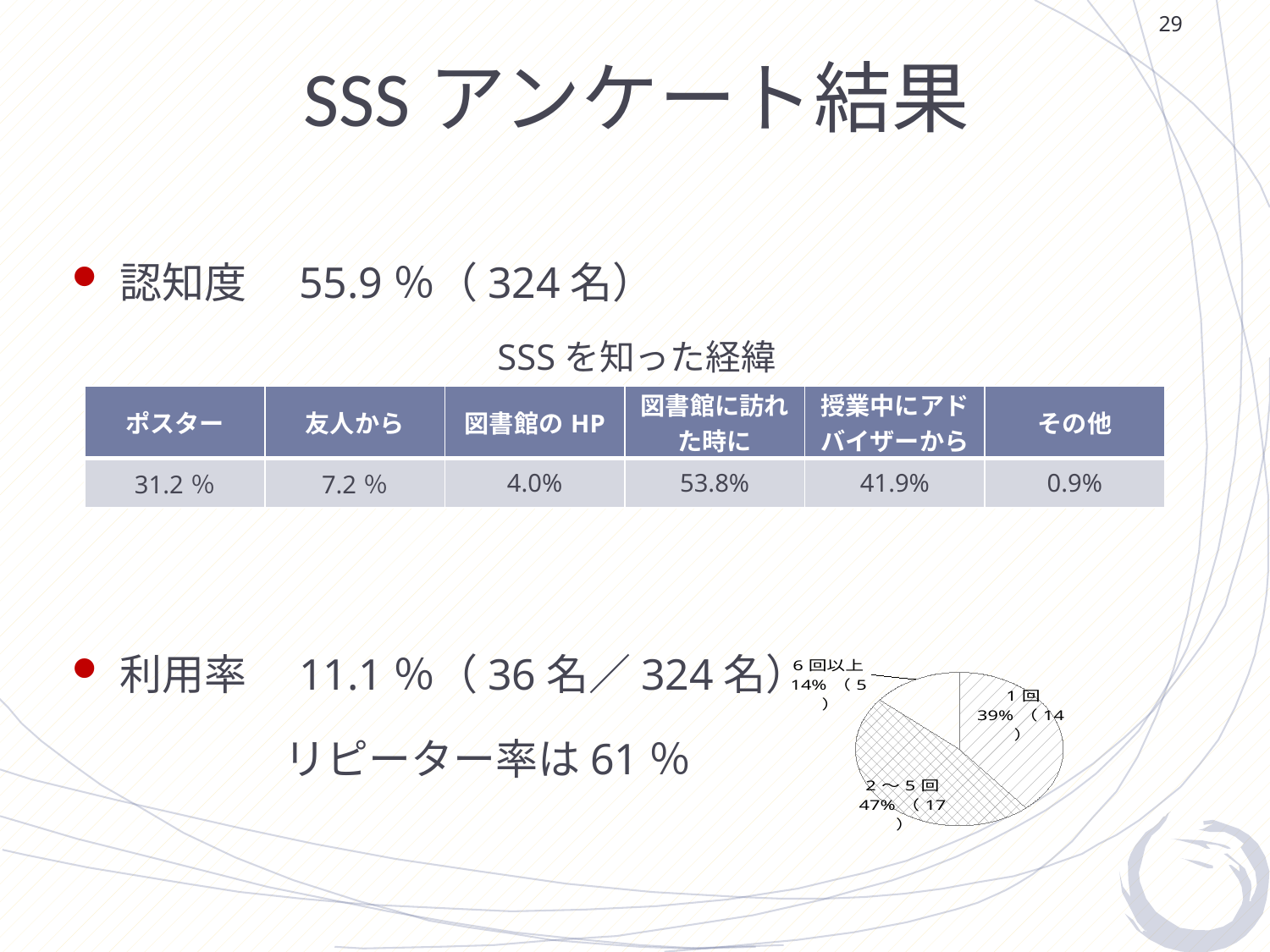
In the pie chart, how many people are shown in parentheses for 1回? 14 In the pie chart, how many people are shown in parentheses for 2～5回? 17 In the pie chart, what share is labelled for 1回? 39% How many slices does the pie chart at the bottom right have? 3 In the pie chart, which is larger, the share for 1回 or the share for 2～5回? 2～5回 Which slice of the pie chart is the smallest? 6回以上 In the pie chart, what share is labelled for 6回以上? 14% Which slice of the pie chart is the largest? 2～5回 What kind of chart is shown at the bottom right of the slide? pie chart In the pie chart, what share is labelled for 2～5回? 47% In the pie chart, what is the difference in percentage points between the 2～5回 share and the 1回 share? 8 In the pie chart, how many people are shown in parentheses for 6回以上? 5